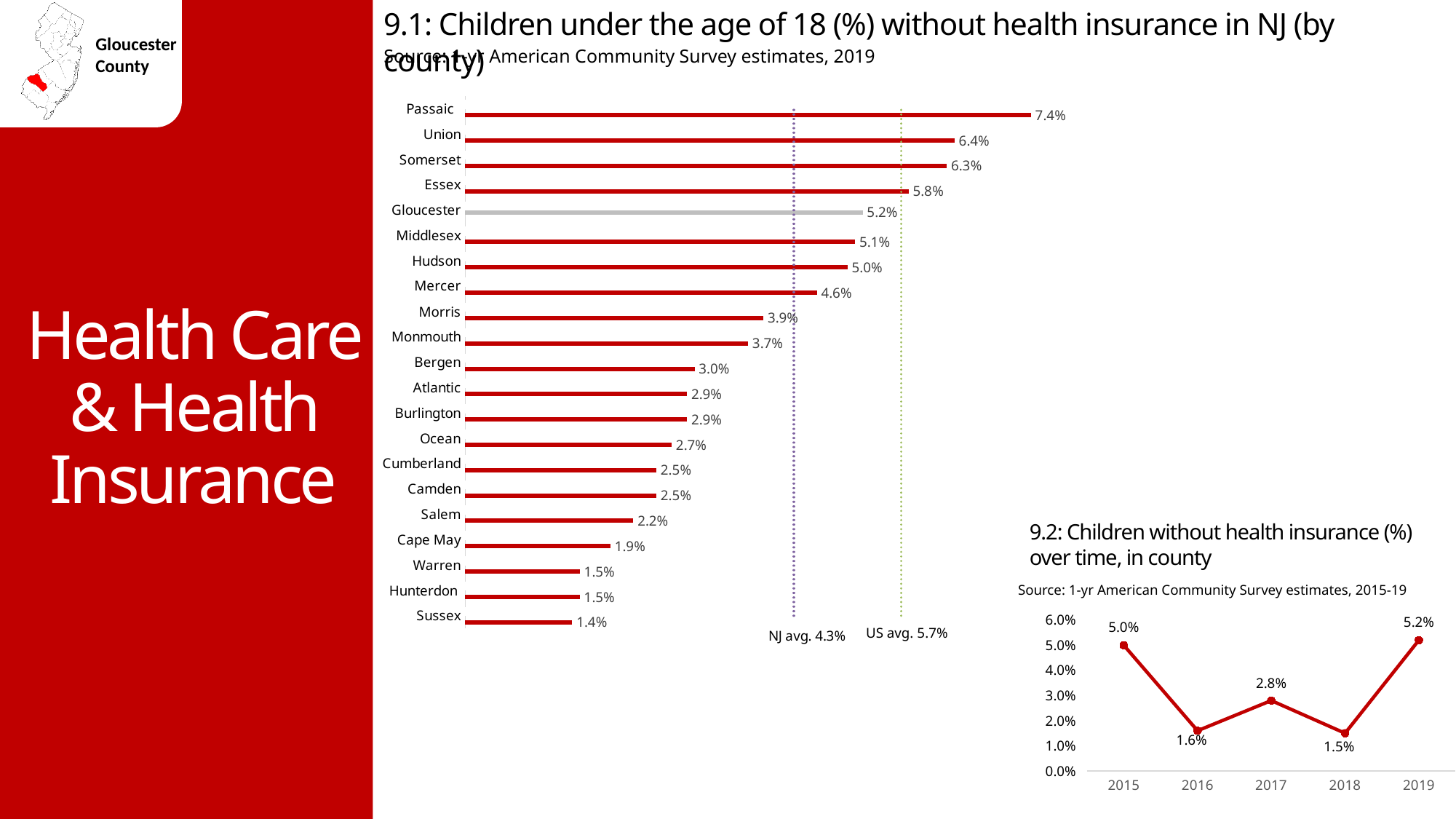
In chart 9.1, which county has the lowest percentage of children without health insurance? Sussex In chart 9.1, how many counties are shown? 21 In chart 9.1, which has a higher value, Mercer or Morris? Mercer What kind of chart is chart 9.2? Line chart What kind of chart is chart 9.1? Bar chart In chart 9.1, what is the NJ average shown by the dotted reference line? 4.3% In chart 9.2 (children without health insurance over time, in county), what is the value for 2017? 2.8% In chart 9.1, what is the difference between the values for Passaic and Sussex? 6.0% In chart 9.2, which year has the lowest value? 2018 In chart 9.1, which county has the highest percentage of children without health insurance? Passaic In chart 9.1 (children under 18 without health insurance by county), what is the value for Gloucester? 5.2% In chart 9.2, what is the difference between the values for 2019 and 2018? 3.7%